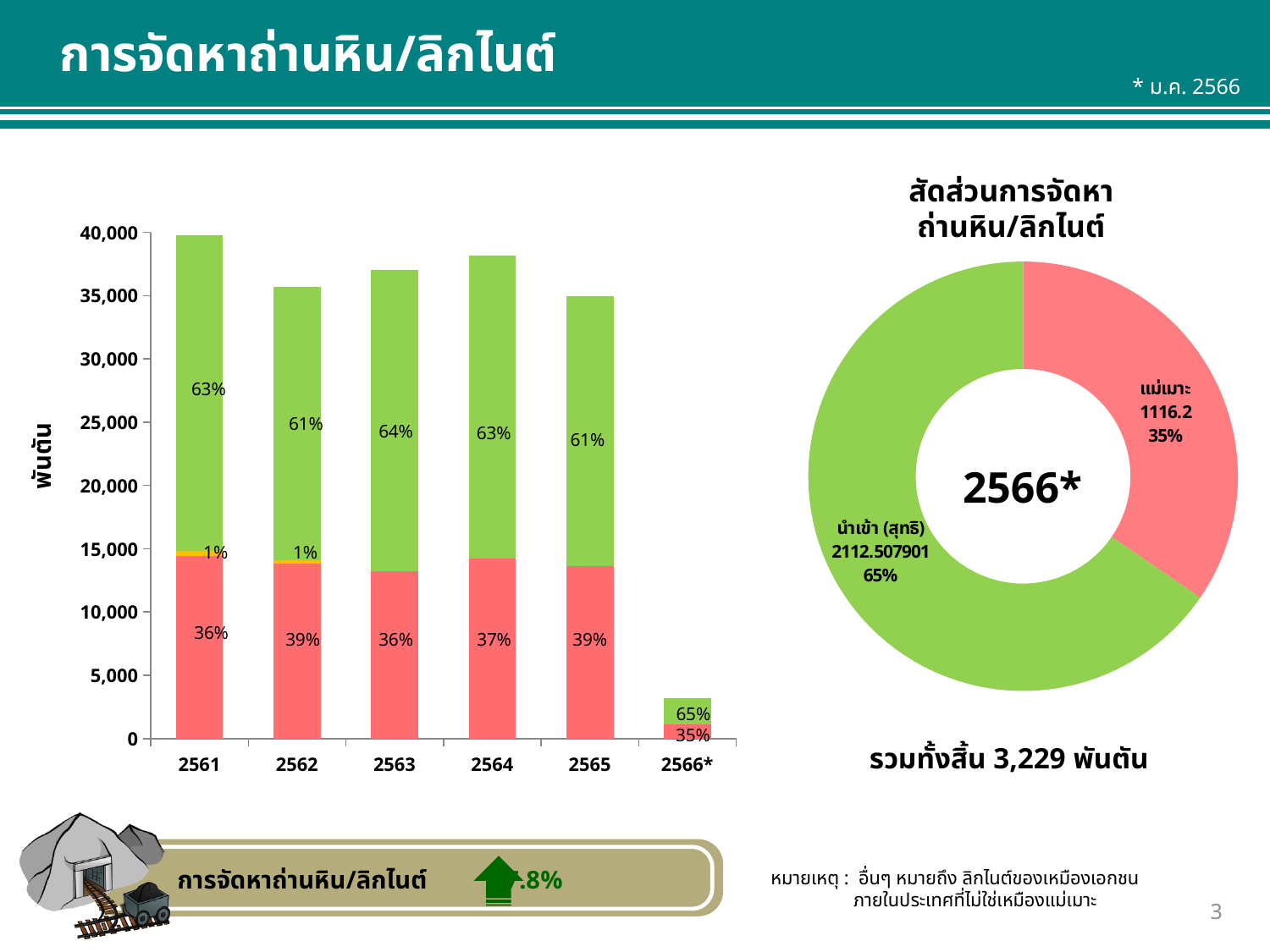
In the stacked bar chart on the left, which year has the tallest bar? 2561 In the donut chart titled สัดส่วนการจัดหาถ่านหิน/ลิกไนต์, what share does นำเข้า (สุทธิ) have? 65% In the stacked bar chart on the left, by how many percentage points does the green segment label for 2563 exceed that for 2562? 3 percentage points In the stacked bar chart on the left, what percentage is labelled on the red segment for 2565? 39% In the stacked bar chart on the left, which year has the shortest bar? 2566* In the donut chart titled สัดส่วนการจัดหาถ่านหิน/ลิกไนต์, what value is shown for แม่เมาะ? 1116.2 In the stacked bar chart on the left, what percentage is labelled on the yellow segment for 2561? 1% In the stacked bar chart on the left, what percentage is labelled on the green segment for 2563? 64% In the stacked bar chart on the left, is the total bar height for 2563 greater or less than 35,000? greater What total is stated below the donut chart titled สัดส่วนการจัดหาถ่านหิน/ลิกไนต์? 3,229 พันตัน In the stacked bar chart on the left, how many years are shown on the x axis? 6 In the stacked bar chart on the left, which year has the larger red segment percentage, 2561 or 2562? 2562